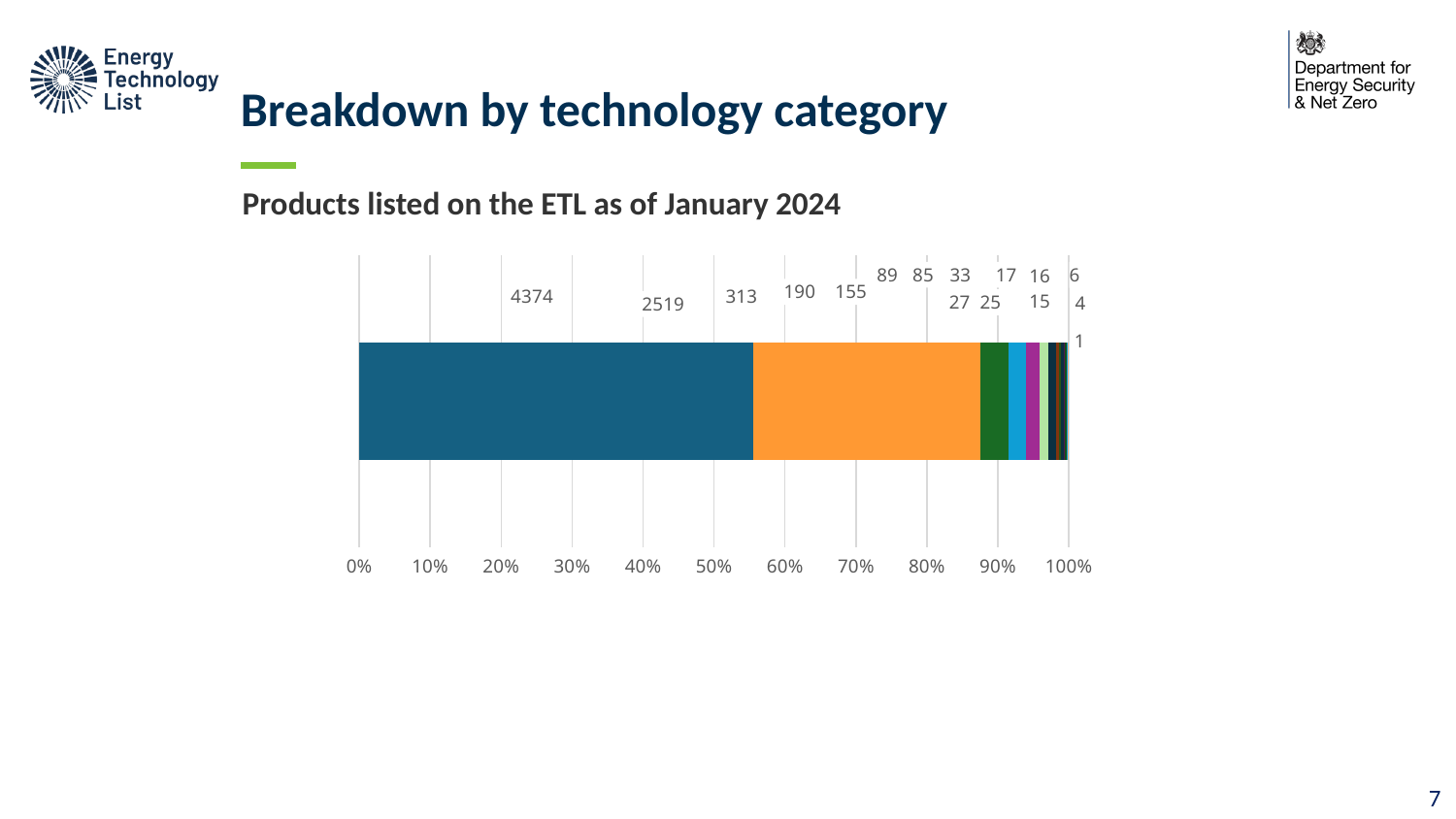
What colour is the largest segment of the bar? dark blue What is the smallest data label shown on the stacked bar? 1 Is the share of the largest segment (4374) greater or less than 50%? greater What is the title of the chart? Products listed on the ETL as of January 2024 Which is larger, the segment labelled 313 or the segment labelled 190? 313 How many data labels (segments) are shown on the stacked bar? 16 What is the second-largest data label shown on the stacked bar? 2519 What is the total of all the data labels on the stacked bar? 7869 What is the difference between the two largest data labels on the bar (4374 and 2519)? 1855 What kind of chart is shown on the slide? bar chart What is the highest value shown on the x axis? 100% What is the largest data label shown on the stacked bar? 4374